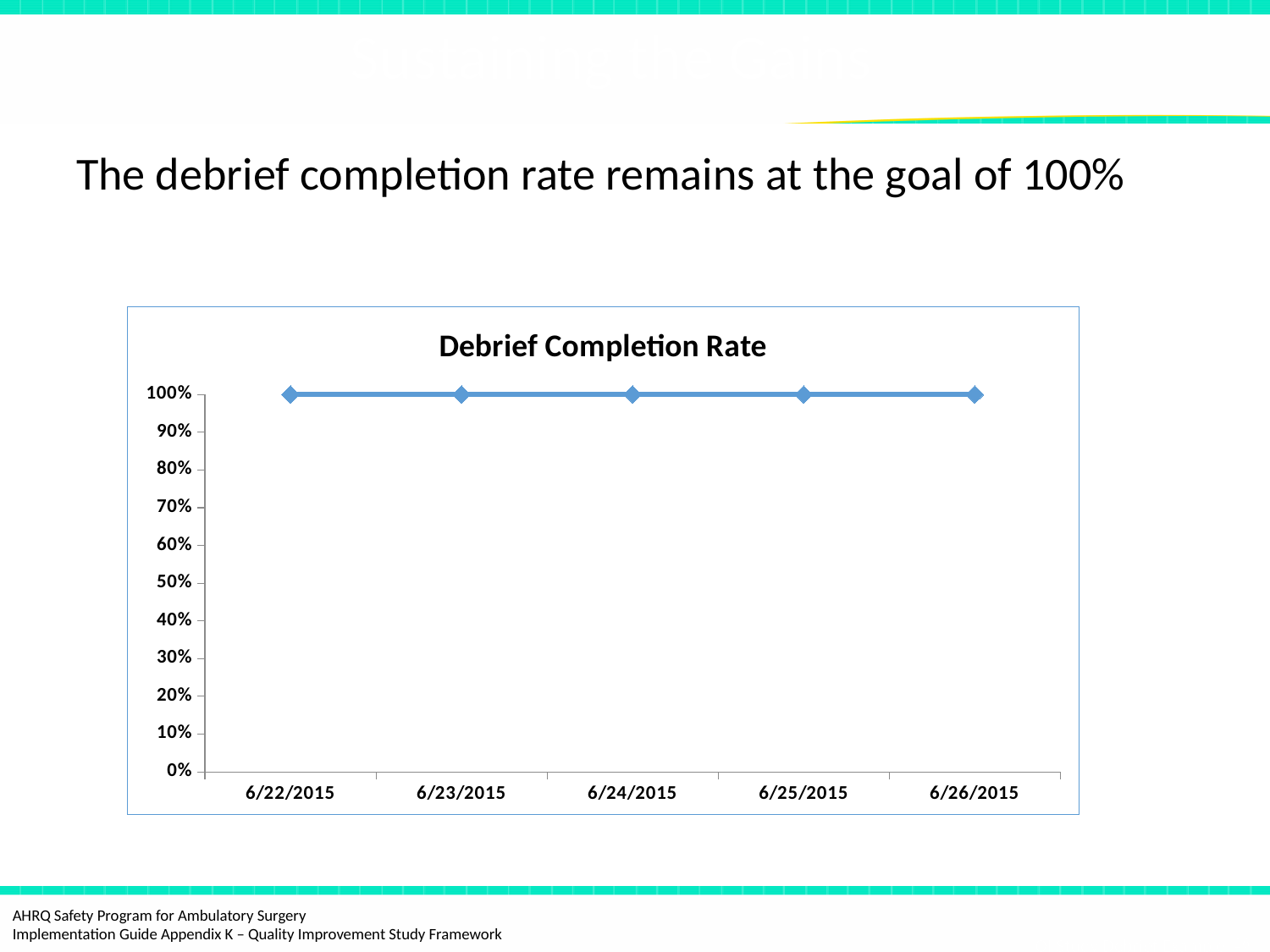
How many dates are plotted on the x axis of the chart? 5 What is the difference between the values for 6/25/2015 and 6/22/2015? 0% What is the first date shown on the x axis? 6/22/2015 What is the title of the chart? Debrief Completion Rate Is the value for 6/23/2015 greater or less than 50%? greater What is the debrief completion rate on 6/26/2015? 100% What is the debrief completion rate on 6/24/2015? 100% What kind of chart is shown on the slide? line chart What is the debrief completion rate on 6/22/2015? 100% Do the values rise, fall, or stay the same from 6/22/2015 to 6/26/2015? stay the same What is the highest value shown on the y axis? 100%